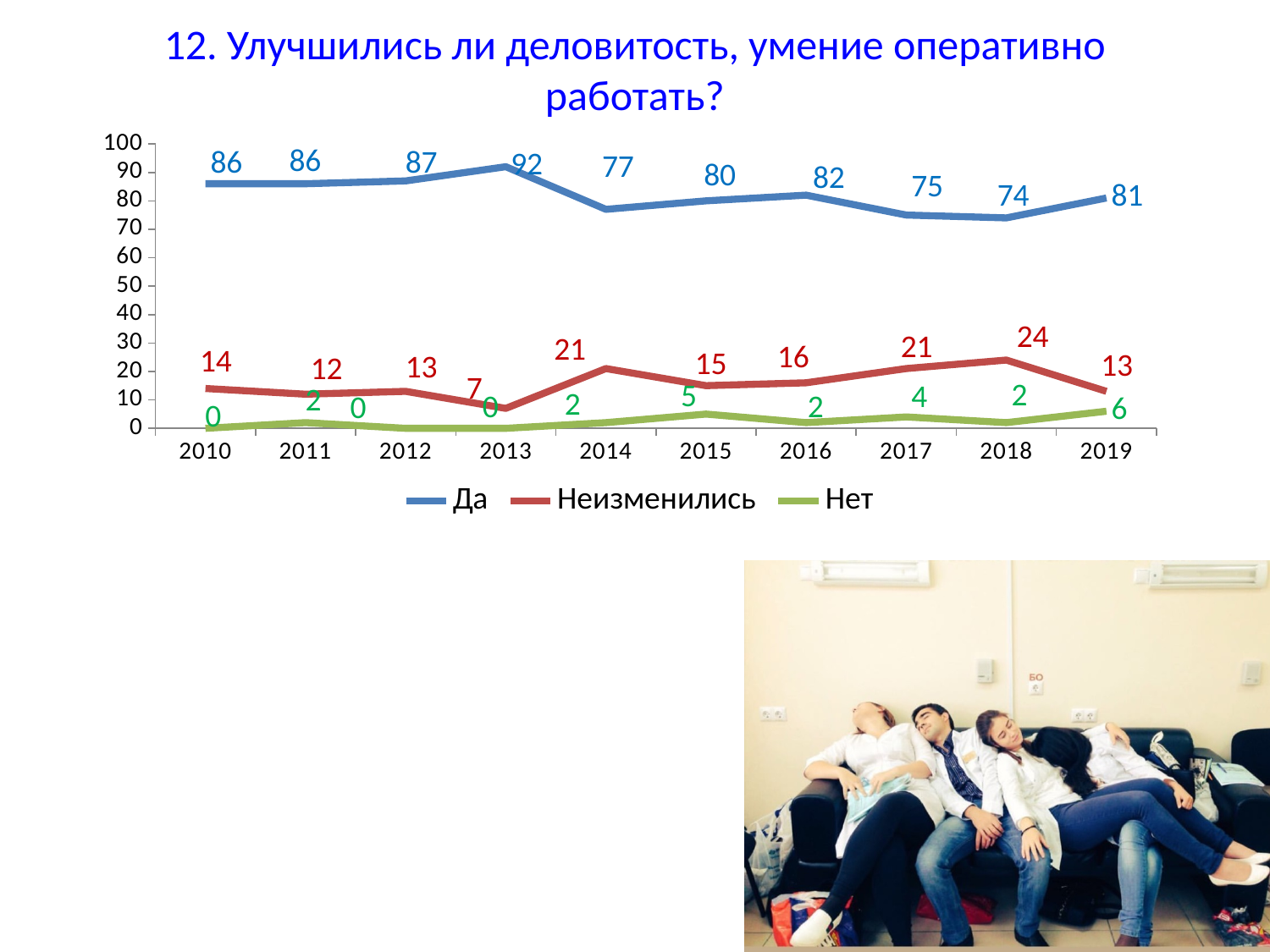
Which series is shown in green in the legend? Нет What is the value of the "Нет" series in 2015? 5 What is the value of the "Да" series in 2013? 92 Which is larger: the "Неизменились" value in 2014 or in 2015? 2014 In which year is the "Неизменились" series at its lowest? 2013 What is the value of the "Неизменились" series in 2018? 24 In which year is the "Да" series at its lowest? 2018 In which year is the "Да" series at its highest? 2013 How many series does the legend list? 3 What is the difference between the "Да" values in 2013 and 2014? 15 How many years are plotted along the x axis? 10 What type of chart is shown on the slide? line chart